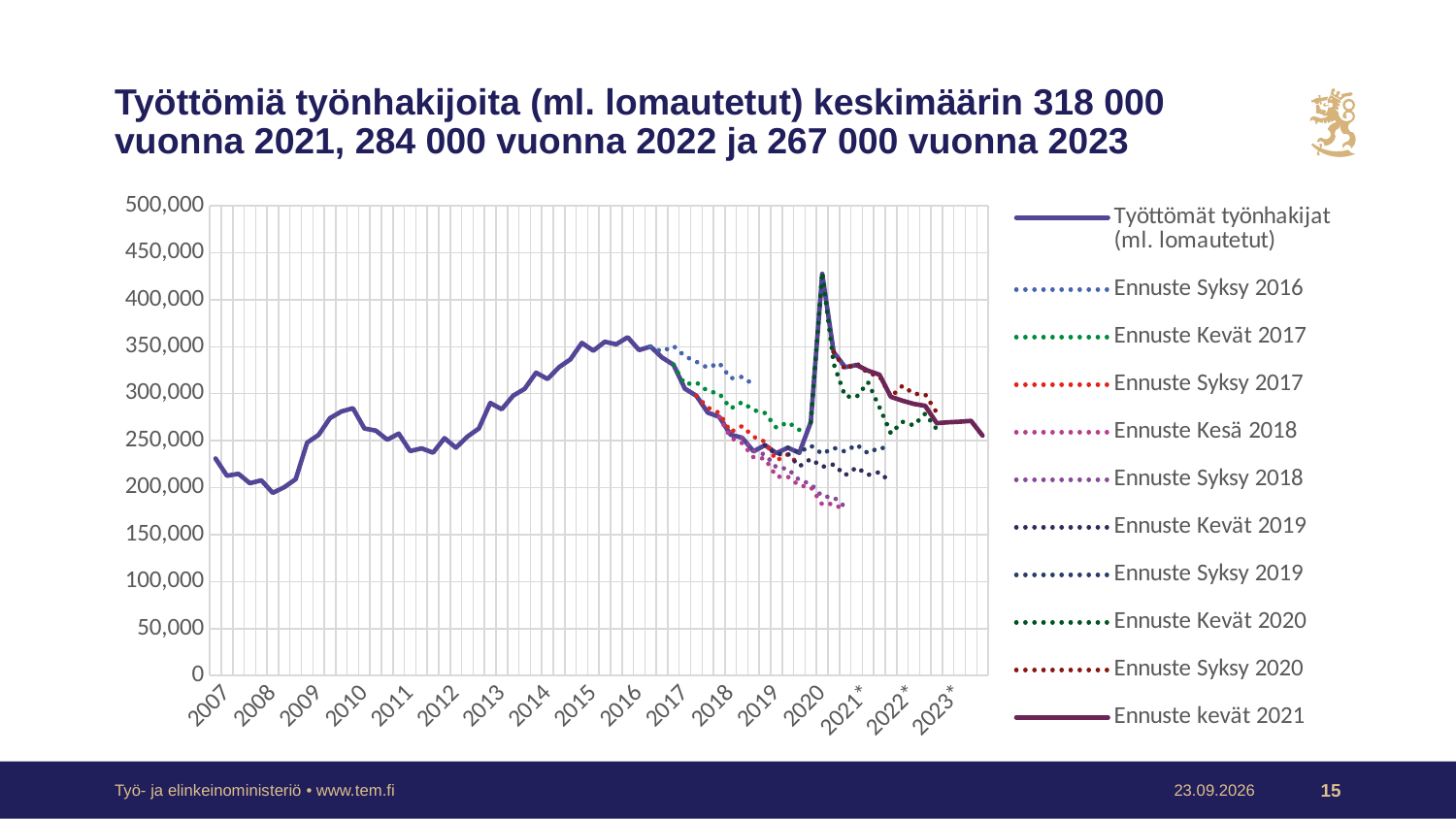
Is the lowest value of the Työttömät työnhakijat (ml. lomautetut) line in 2008 greater or less than 250,000? less Does the Työttömät työnhakijat (ml. lomautetut) line rise or fall between 2009 and 2016? rise In which year does the Työttömät työnhakijat (ml. lomautetut) line reach its lowest point? 2008 Is the peak value of the Työttömät työnhakijat (ml. lomautetut) line in 2020 greater or less than 400,000? greater In which year does the Työttömät työnhakijat (ml. lomautetut) line reach its highest peak? 2020 Is the final value of the Ennuste Kesä 2018 line greater or less than 200,000? less How many year labels are shown on the x axis? 17 According to the slide title, what is the average number of unemployed jobseekers (incl. laid-off) in 2021? 318 000 What kind of chart is shown on the slide? line chart How many series does the legend list? 11 What is the highest value shown on the y axis? 500,000